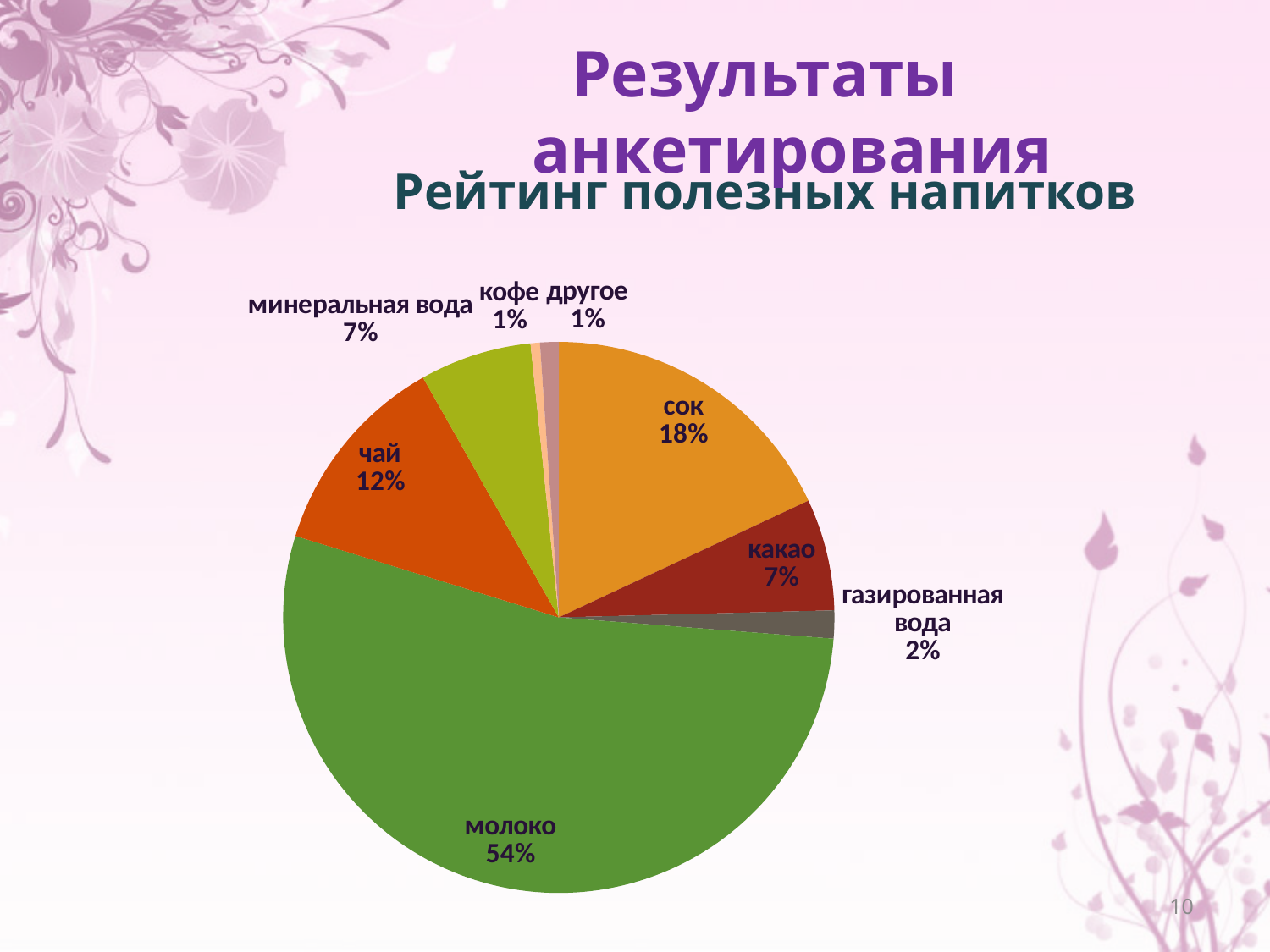
What share of the pie does молоко have? 54% What is the difference between the values for молоко and сок? 36% What kind of chart is shown on the slide? pie chart What is the value for газированная вода? 2% How many categories are shown in the pie chart? 8 What is the difference between the values for сок and чай? 6% Which is larger, какао or газированная вода? какао Which category has the largest slice? молоко What is the value for сок? 18% What colour is the slice for молоко? green What is the value for чай? 12% What is the title of the chart? Рейтинг полезных напитков